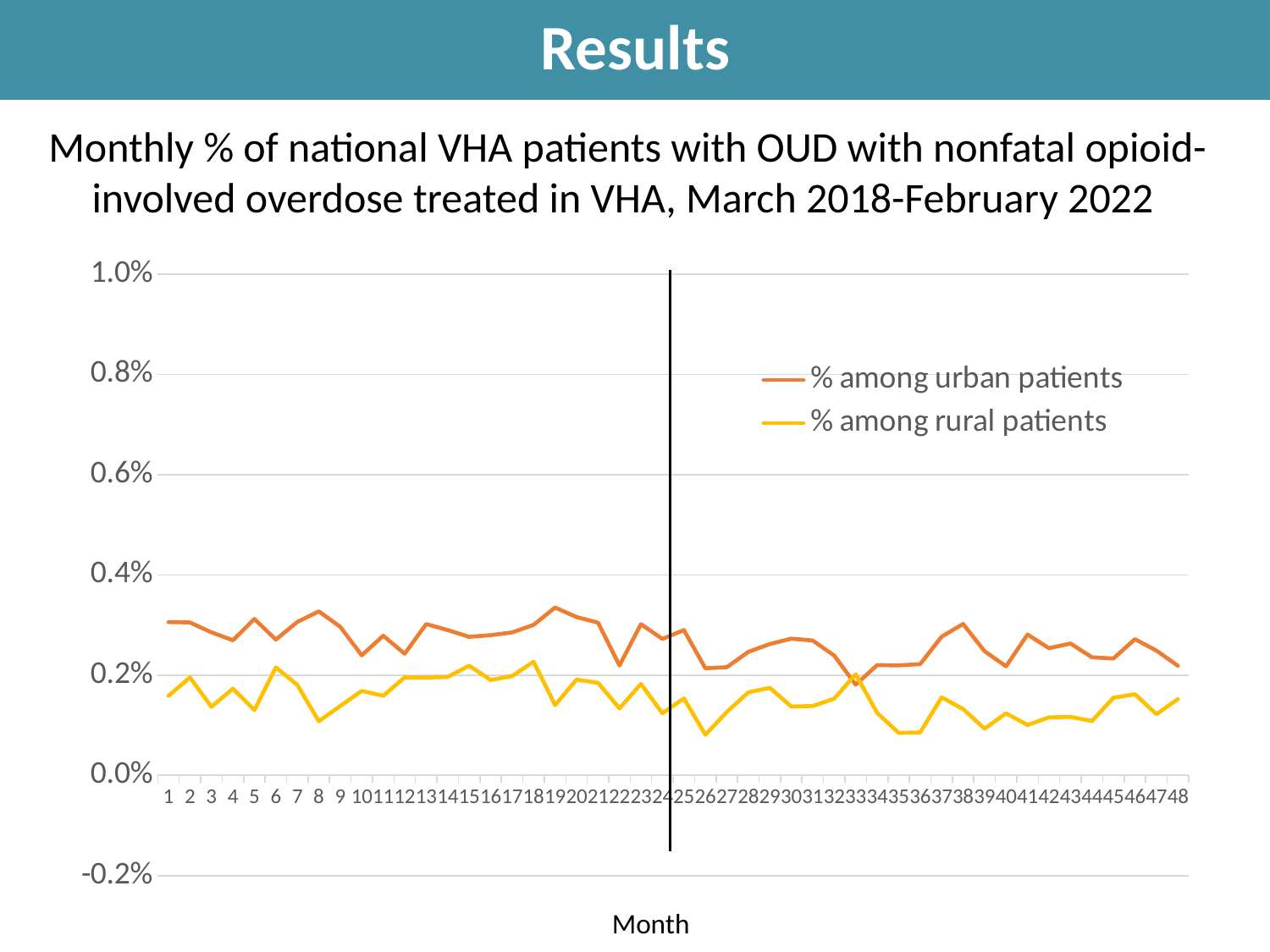
What kind of chart is shown on the slide? line chart Is the value for % among urban patients at month 1 greater or less than 0.4%? less What is the title of the x axis? Month Which series is drawn in yellow? % among rural patients Is the value for % among urban patients at month 38 greater or less than 0.2%? greater Is the value for % among rural patients at month 26 greater or less than 0.2%? less How many months are plotted along the x axis? 48 How many series does the legend list? 2 At month 1, which series has the larger value, % among urban patients or % among rural patients? % among urban patients At month 48, which series has the larger value, % among urban patients or % among rural patients? % among urban patients